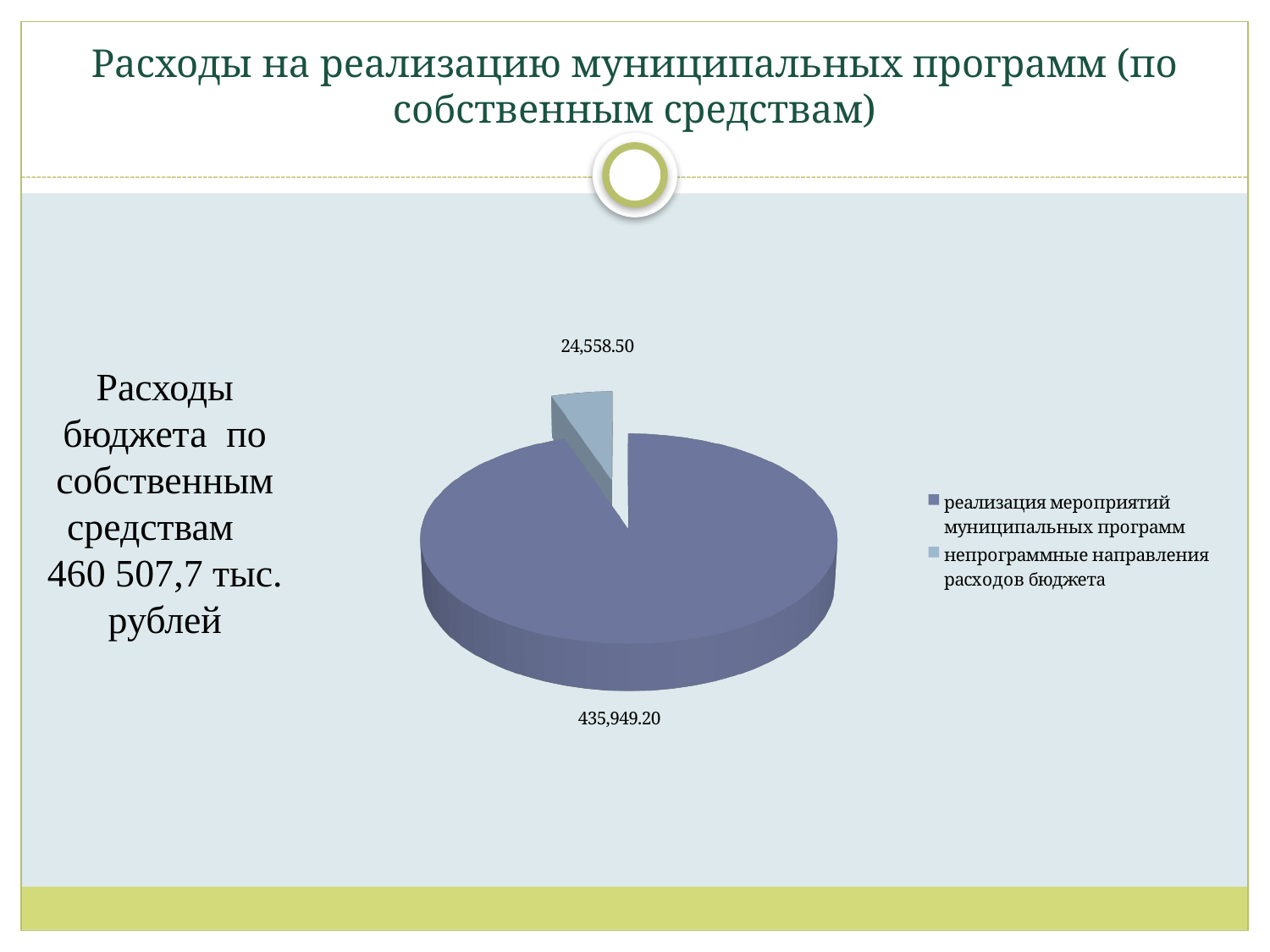
What is the difference between the value for "реализация мероприятий муниципальных программ" and the value for "непрограммные направления расходов бюджета"? 411,390.70 How many slices does the pie chart have? 2 What share of the pie does "непрограммные направления расходов бюджета" represent, to the nearest whole percent? 5% How many entries does the legend list? 2 What is the title of the slide containing the chart? Расходы на реализацию муниципальных программ (по собственным средствам) What is the total of the two values shown on the pie chart? 460,507.70 What is the value for "реализация мероприятий муниципальных программ"? 435,949.20 What type of chart is shown on the slide? Pie chart Which category has the smallest slice of the pie? непрограммные направления расходов бюджета Which category has the largest slice of the pie? реализация мероприятий муниципальных программ What is the value for "непрограммные направления расходов бюджета"? 24,558.50 Which is larger: the value for "реализация мероприятий муниципальных программ" or the value for "непрограммные направления расходов бюджета"? реализация мероприятий муниципальных программ